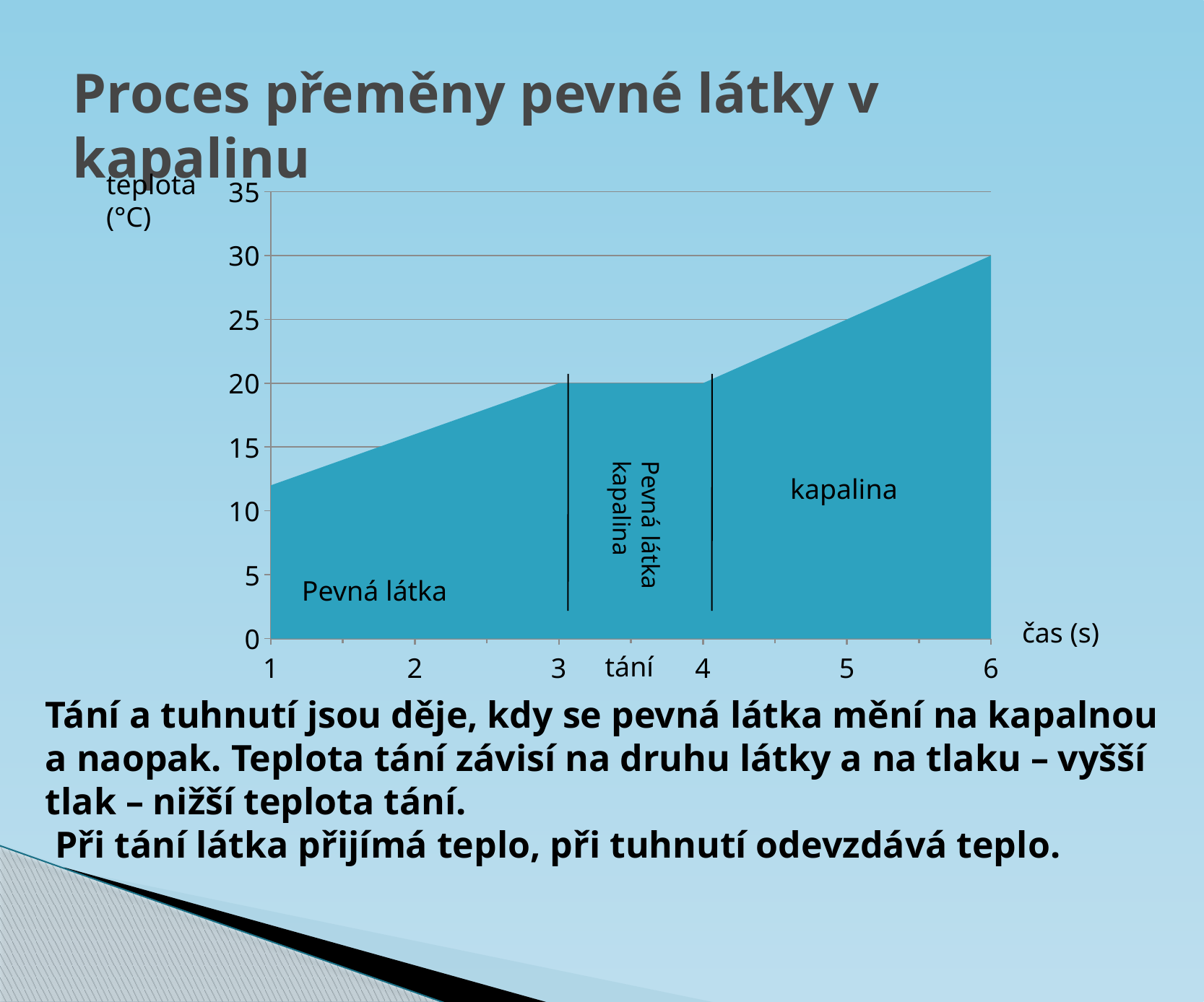
What is the temperature at time 3 s? 20 At which time on the x axis is the temperature lowest? 1 Does the temperature rise, fall or stay constant between time 3 s and time 4 s? stays constant Is the temperature at time 2 s greater or less than 15? greater Is the temperature at time 1 s greater or less than 15? less What kind of chart is shown on the slide? area chart What is the difference in temperature between time 6 s and time 3 s? 10 Is the temperature at time 5 s greater or less than 20? greater What is the label of the y axis? teplota (°C) At which time on the x axis is the temperature highest? 6 What is the temperature at time 4 s? 20 What is the temperature at time 6 s? 30